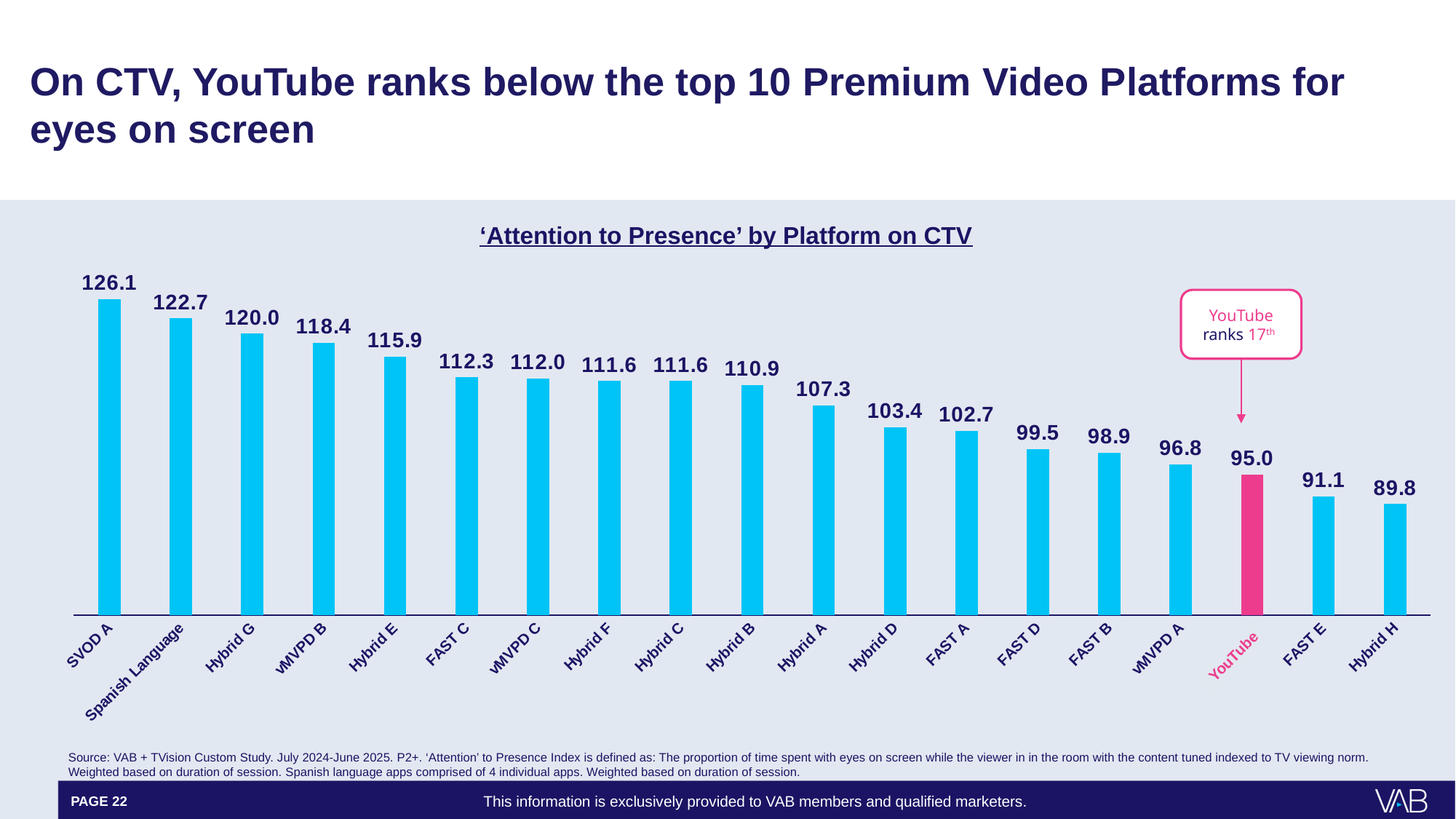
How many platforms are shown in the chart? 19 What is the 'Attention to Presence' value for YouTube? 95.0 What is the difference between the values for YouTube and FAST E? 3.9 Which has a higher value, FAST D or vMVPD A? FAST D Do the values rise or fall from left to right across the chart? Fall What is the value shown for Hybrid A? 107.3 What kind of chart is shown on the slide? Bar chart What is the difference between the values for SVOD A and YouTube? 31.1 Which platform has the highest 'Attention to Presence' value? SVOD A What is the value shown for Spanish Language? 122.7 According to the callout on the chart, what rank does YouTube hold? 17th Which platform has the lowest 'Attention to Presence' value? Hybrid H